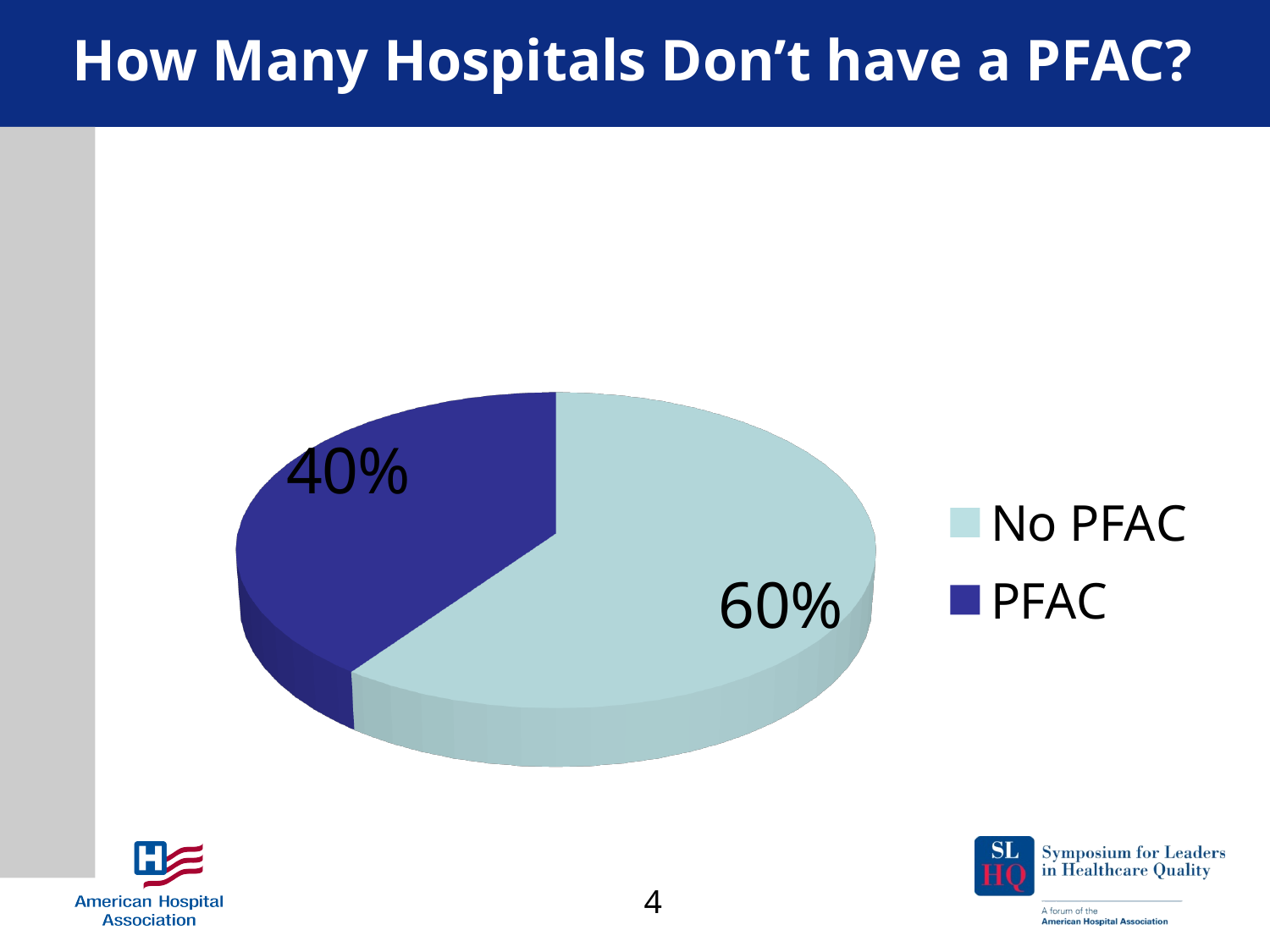
How many slices does the pie chart have? 2 What is the title of the slide containing the chart? How Many Hospitals Don't have a PFAC? What share of the pie is labelled PFAC? 40% Which category has the largest slice of the pie? No PFAC Which category has the smallest slice of the pie? PFAC How many entries does the legend list? 2 Which slice is larger, No PFAC or PFAC? No PFAC Which legend entry is shown in dark blue? PFAC What is the difference in percentage points between the No PFAC and PFAC slices? 20 Is the share for PFAC greater or less than 50%? less What share of the pie is labelled No PFAC? 60% What kind of chart is shown on the slide? Pie chart